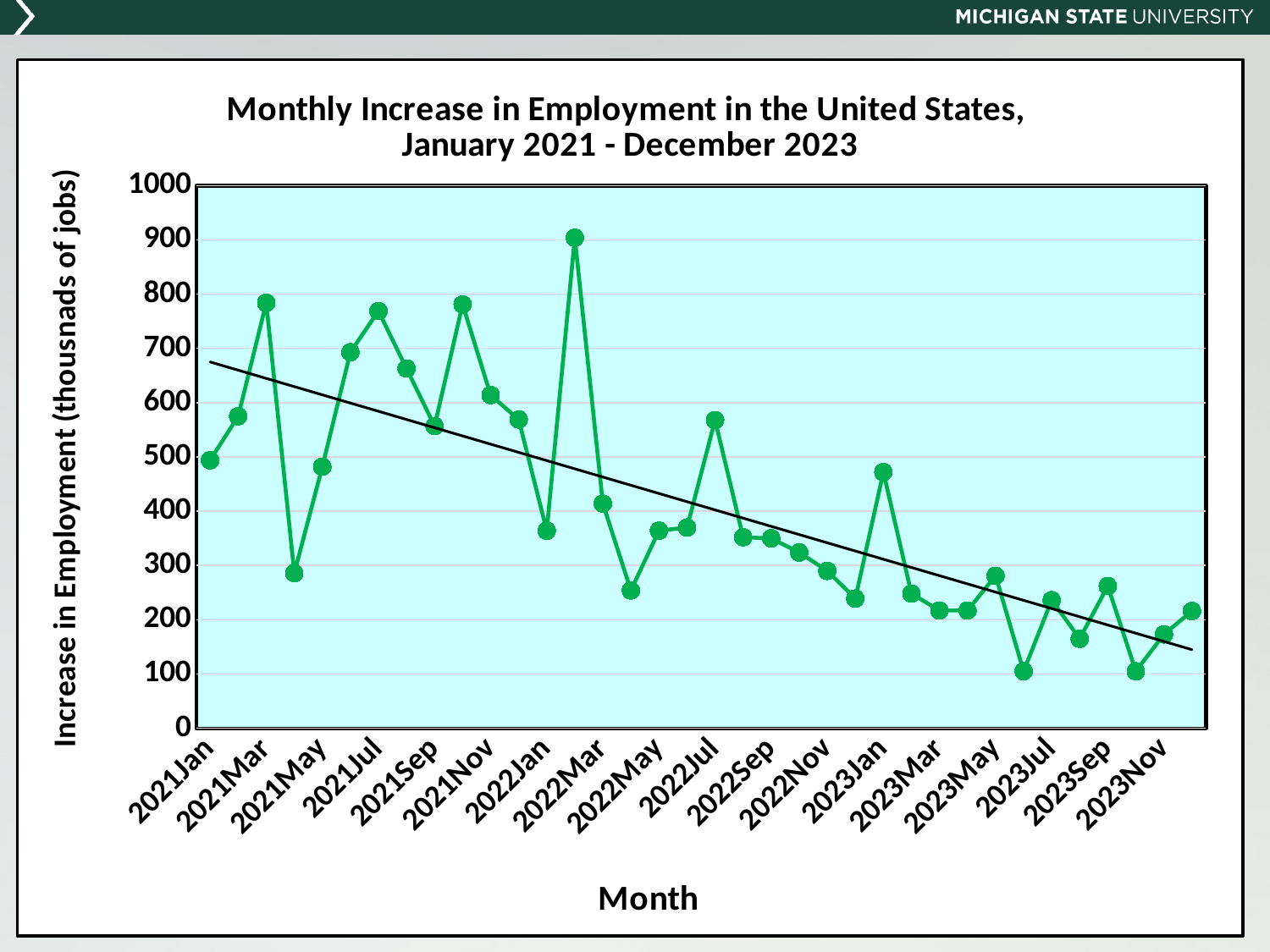
Which month has the larger value, 2022Jul or 2022Sep? 2022Jul Is the value for 2022Jan greater or less than 400? less How many monthly data points are plotted on the chart? 36 Which month has the larger value, 2023Mar or 2023Jan? 2023Jan Is the value for 2021Mar greater or less than 700? greater Is the value for 2023Nov greater or less than 200? less What is the label of the vertical axis? Increase in Employment (thousnads of jobs) Overall, do the plotted values rise or fall from January 2021 to December 2023? Fall Which month has the larger value, 2021Mar or 2021May? 2021Mar What kind of chart is shown on the slide? Line chart What is the title of the chart? Monthly Increase in Employment in the United States, January 2021 - December 2023